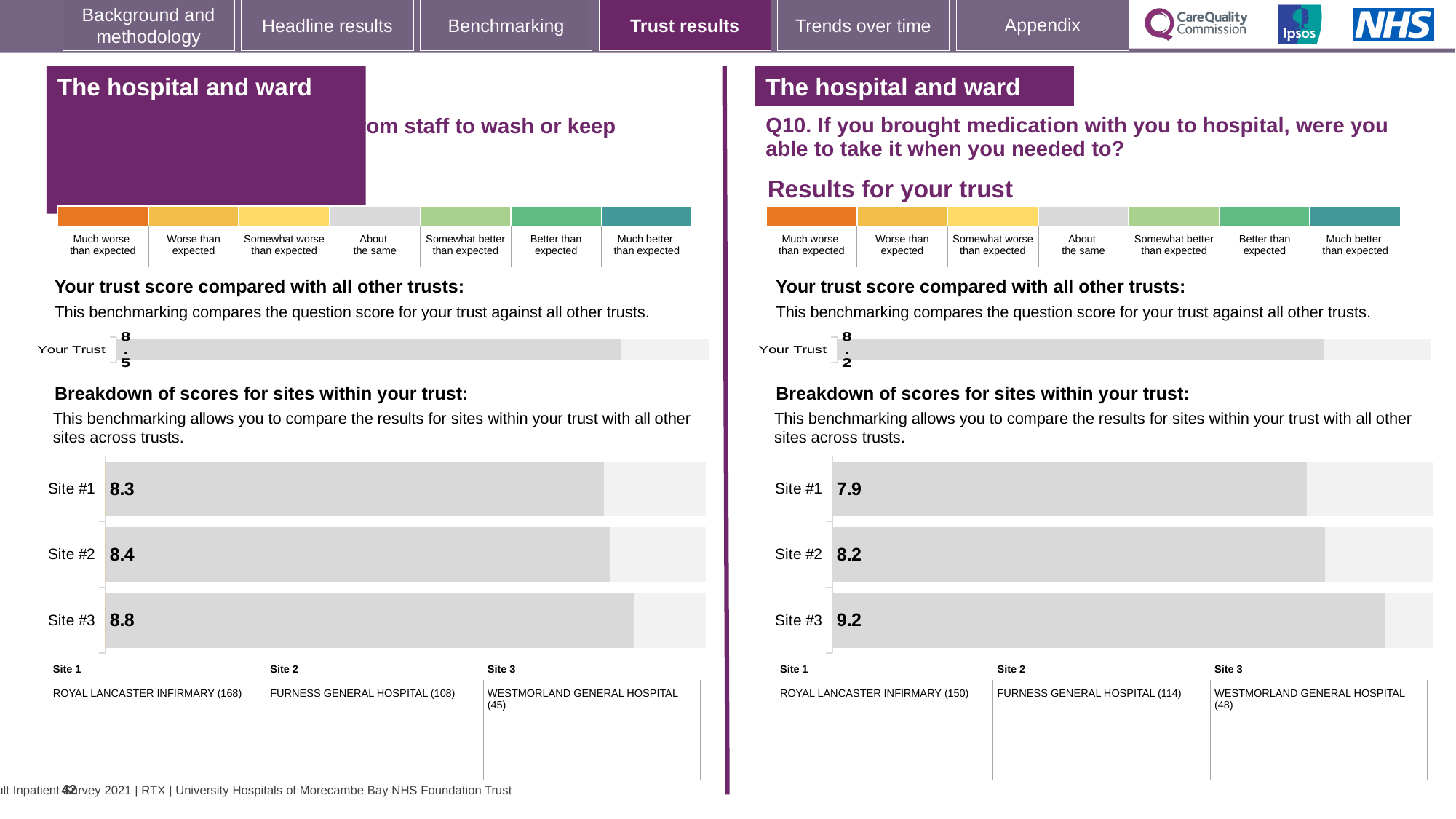
In the left-hand site breakdown chart, what is the score for Site #2? 8.4 In the right-hand chart for Q10, what is the score for Site #1? 7.9 In the left-hand site breakdown chart, which site has the highest score? Site #3 In the right-hand chart for Q10, which site has the lowest score? Site #1 What kind of chart is used for the site breakdown on the right-hand side of the slide? Bar chart In the left-hand site breakdown chart, what is the difference between the scores for Site #3 and Site #1? 0.5 In the right-hand 'Your trust score compared with all other trusts' chart for Q10, what is the score for Your Trust? 8.2 In the right-hand chart for Q10 (medication brought to hospital), what is the score for Site #3? 9.2 How many sites are shown in the right-hand site breakdown chart for Q10? 3 In the left-hand 'Your trust score compared with all other trusts' chart, what is the score for Your Trust? 8.5 In the right-hand chart for Q10, what is the difference between the scores for Site #3 and Site #1? 1.3 In the left-hand site breakdown chart, which is larger: the score for Site #1 or Site #3? Site #3